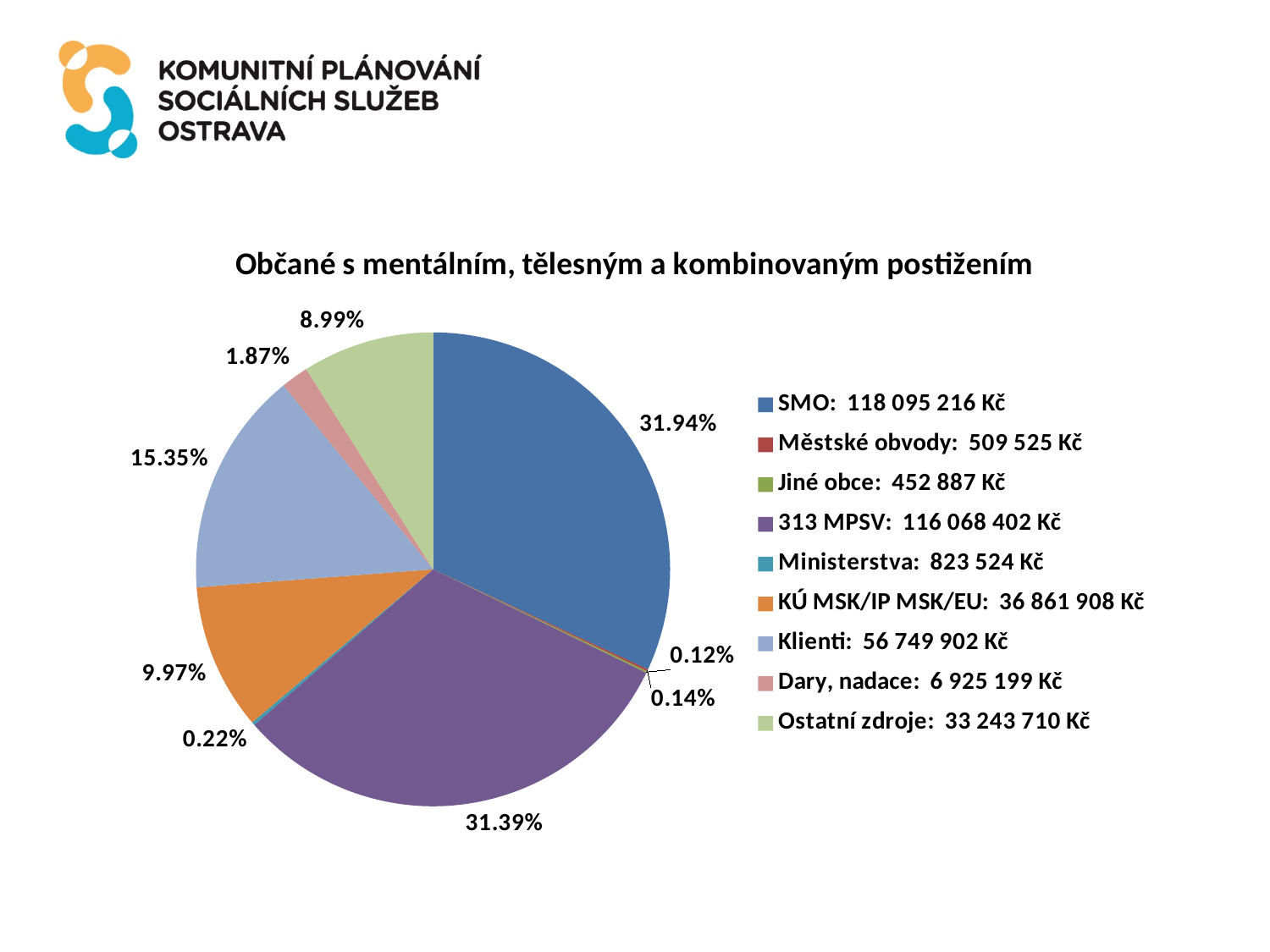
What is the title of the chart? Občané s mentálním, tělesným a kombinovaným postižením How many slices does the pie chart have? 9 Which category has the largest slice of the pie? SMO Which category has the smallest slice of the pie? Jiné obce What kind of chart is shown on the slide? pie chart What share of the pie does 313 MPSV represent? 31.39% What share of the pie does SMO represent? 31.94% What is the value shown in the legend for KÚ MSK/IP MSK/EU? 36 861 908 Kč Which is larger, the value for Klienti or the value for Ostatní zdroje? Klienti What share of the pie does Klienti represent? 15.35% What is the value shown in the legend for Dary, nadace? 6 925 199 Kč What is the difference in percentage points between the SMO slice and the 313 MPSV slice? 0.55%